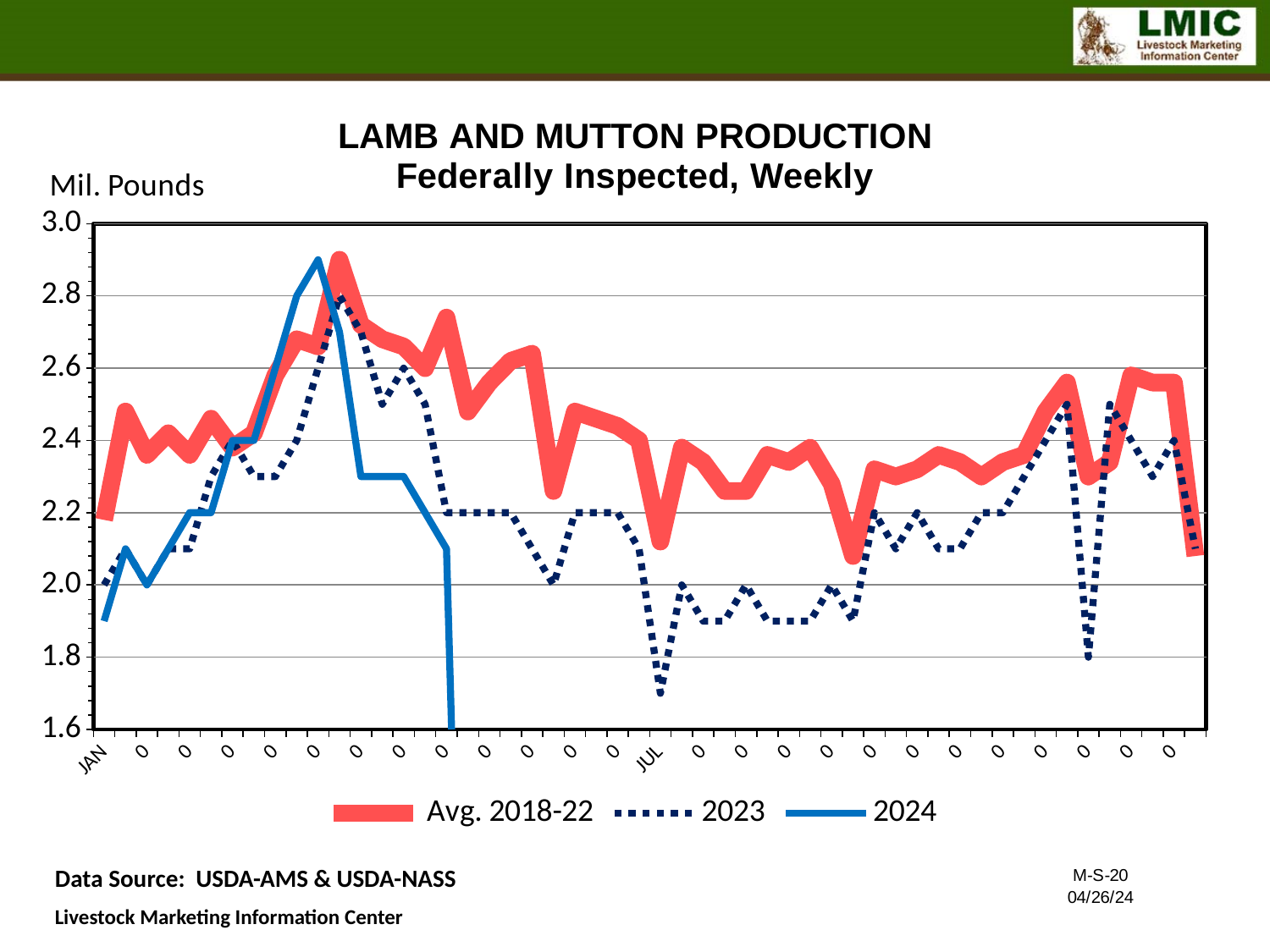
At JAN, which series has the higher value: Avg. 2018-22 or 2024? Avg. 2018-22 How many series does the legend list? 3 Is the lowest value of the 2023 series greater or less than 1.8? less Does the 2024 series rise or fall from JAN to its peak? rise Around JUL, which series has the higher value: Avg. 2018-22 or 2023? Avg. 2018-22 Is the peak value of the 2024 series greater or less than 2.8? greater Does the Avg. 2018-22 series generally rise or fall from its peak to the end of the year? fall What kind of chart is shown on the slide? line chart Which series are listed in the chart legend? Avg. 2018-22, 2023, 2024 Is the peak value of the Avg. 2018-22 series greater or less than 2.8? greater What unit is shown on the y axis of the chart? Mil. Pounds